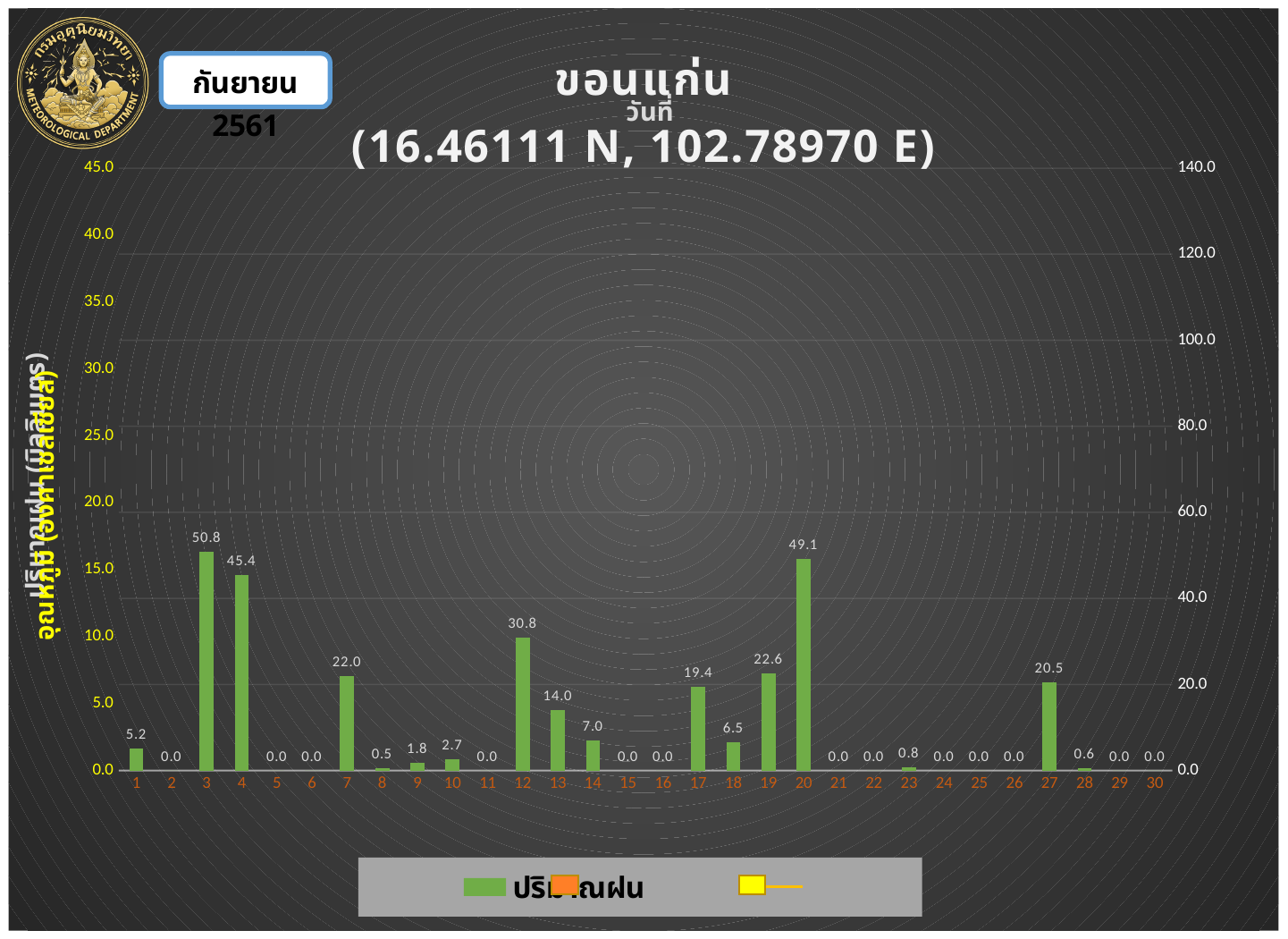
Which is larger, the rainfall value for day 20 or for day 12? day 20 What is the difference between the rainfall values for day 3 and day 4? 5.4 How many days are shown on the x axis? 30 What is the rainfall value shown for day 3? 50.8 What is the rainfall value shown for day 27? 20.5 Which day has the highest rainfall value? 3 What coordinates are given in the chart title? 16.46111 N, 102.78970 E Which is larger, the rainfall value for day 17 or for day 13? day 17 What kind of chart is shown on the slide? bar chart What is the rainfall value shown for day 20? 49.1 What is the rainfall value shown for day 12? 30.8 What is the difference between the rainfall values for day 19 and day 7? 0.6